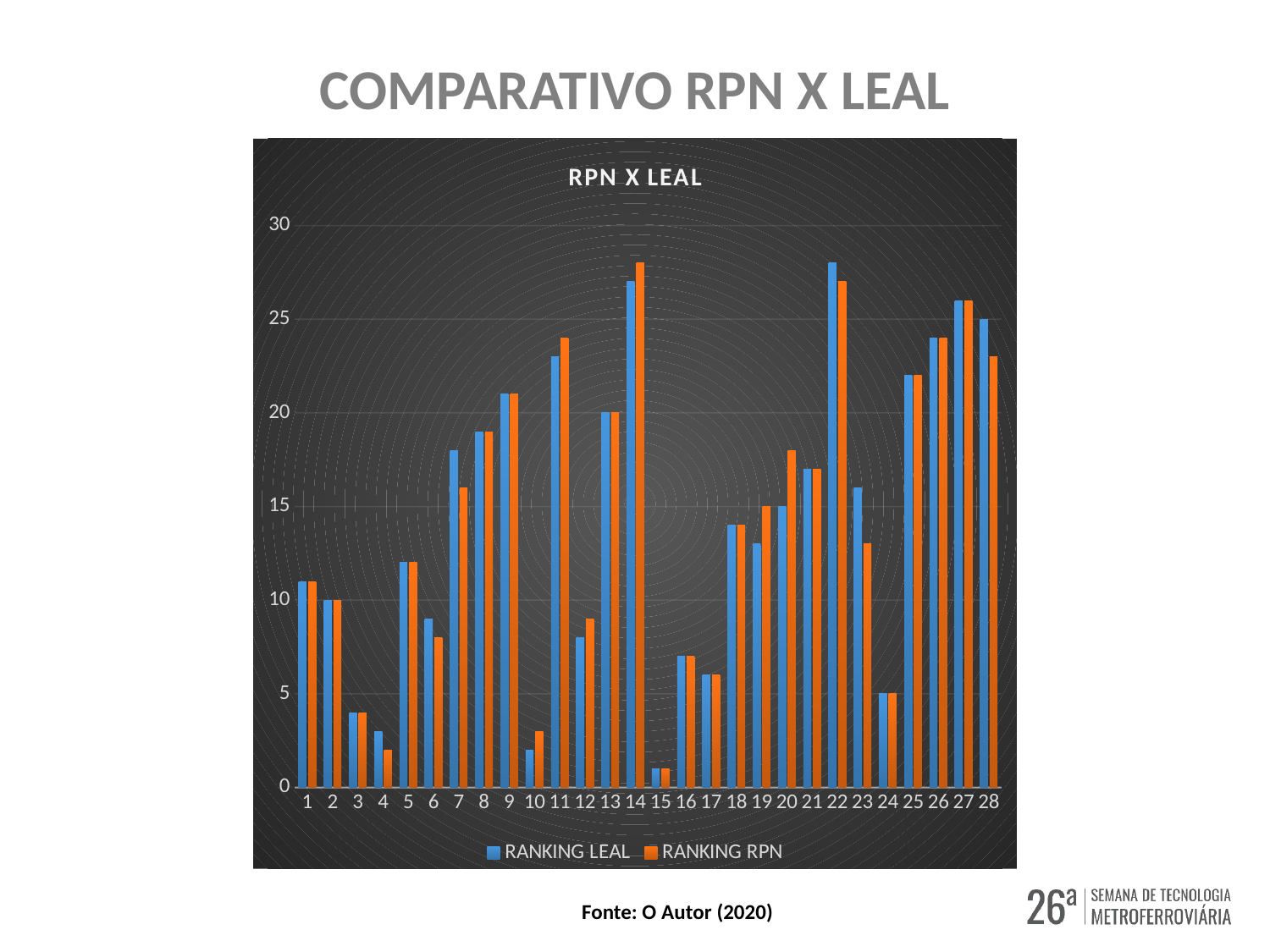
For category 23, which series has the larger value, RANKING LEAL or RANKING RPN? RANKING LEAL Is the RANKING LEAL value for category 7 greater or less than 15? greater What is the title shown inside the chart area? RPN X LEAL For category 20, which series has the larger value, RANKING LEAL or RANKING RPN? RANKING RPN Is the RANKING RPN value for category 11 greater or less than 20? greater What kind of chart is shown on the slide? bar chart What is the RANKING LEAL value for category 13? 20 Is the RANKING RPN value for category 23 greater or less than 15? less How many series does the legend list? 2 What is the RANKING RPN value for category 24? 5 Which category has the lowest values for both RANKING LEAL and RANKING RPN? 15 How many categories are shown on the x axis? 28